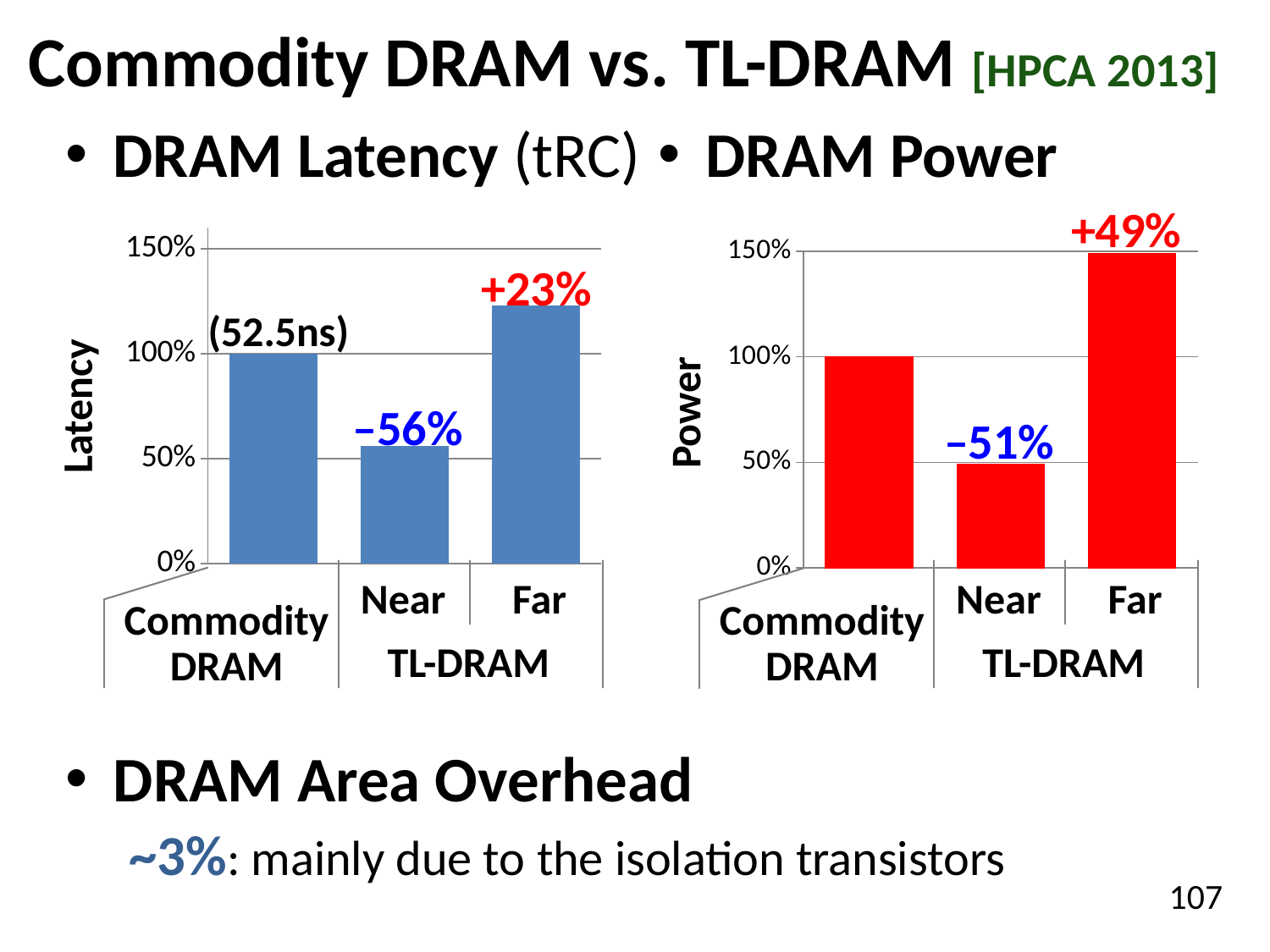
In the DRAM Power chart on the right, which bar is the lowest? Near In the DRAM Power chart on the right, is the value for Far greater or less than 100%? greater In the DRAM Power chart on the right, what percentage change is labeled above the Far bar? +49% In the DRAM Latency chart on the left, is the value for Near greater or less than 50%? greater In the DRAM Latency chart on the left, what value does the Commodity DRAM bar reach on the y axis? 100% In the DRAM Latency chart on the left, what percentage change is labeled above the Far bar? +23% In the DRAM Power chart on the right, which is larger, the Commodity DRAM bar or the Near bar? Commodity DRAM How many bars are plotted in the DRAM Latency chart on the left? 3 In the DRAM Latency chart on the left, which bar is the highest? Far In the DRAM Latency chart on the left, what percentage change is labeled above the Near bar? –56% In the DRAM Power chart on the right, what percentage change is labeled above the Near bar? –51% What absolute latency value is annotated above the Commodity DRAM bar in the DRAM Latency chart? (52.5ns)